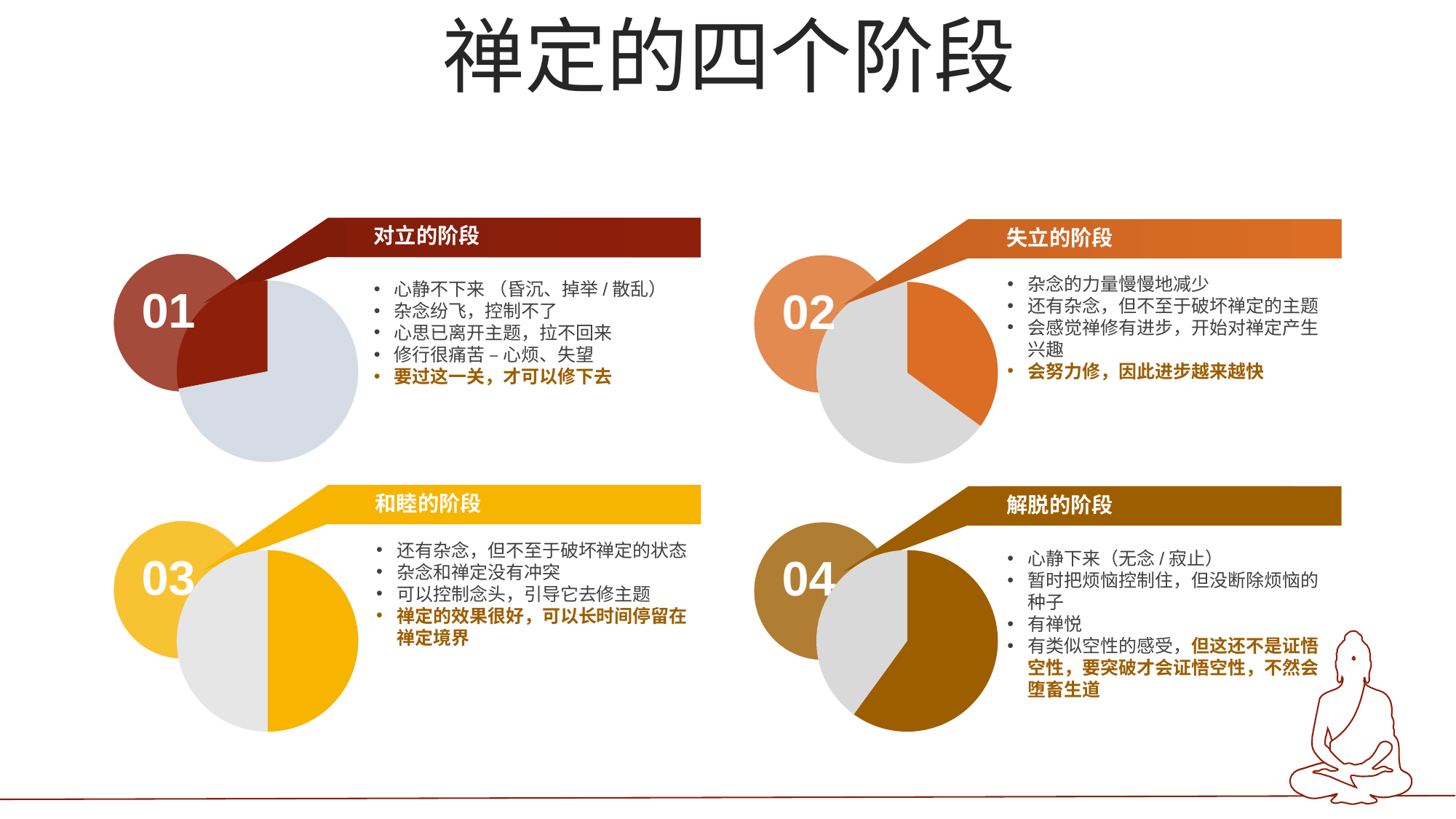
Which stage's pie chart has the smallest coloured (non-grey) slice? 01 (对立的阶段) What kind of chart is shown next to stage 01 (对立的阶段)? pie chart How many pie charts are on the slide? 4 Which stage's pie chart has the largest coloured (non-grey) slice? 04 (解脱的阶段) In the pie chart next to stage 04 (解脱的阶段), which slice is larger, the grey slice or the brown slice? the brown slice What colour is the non-grey slice in the pie chart next to stage 03 (和睦的阶段)? yellow What is the title of the slide containing the four pie charts? 禅定的四个阶段 In the pie chart next to stage 02 (失立的阶段), which slice is larger, the grey slice or the orange slice? the grey slice In the pie chart next to stage 01 (对立的阶段), which slice is larger, the grey slice or the dark red slice? the grey slice Across the four pie charts from stage 01 to stage 04, does the coloured (non-grey) share increase or decrease? increase How many slices does the pie chart next to stage 02 (失立的阶段) have? 2